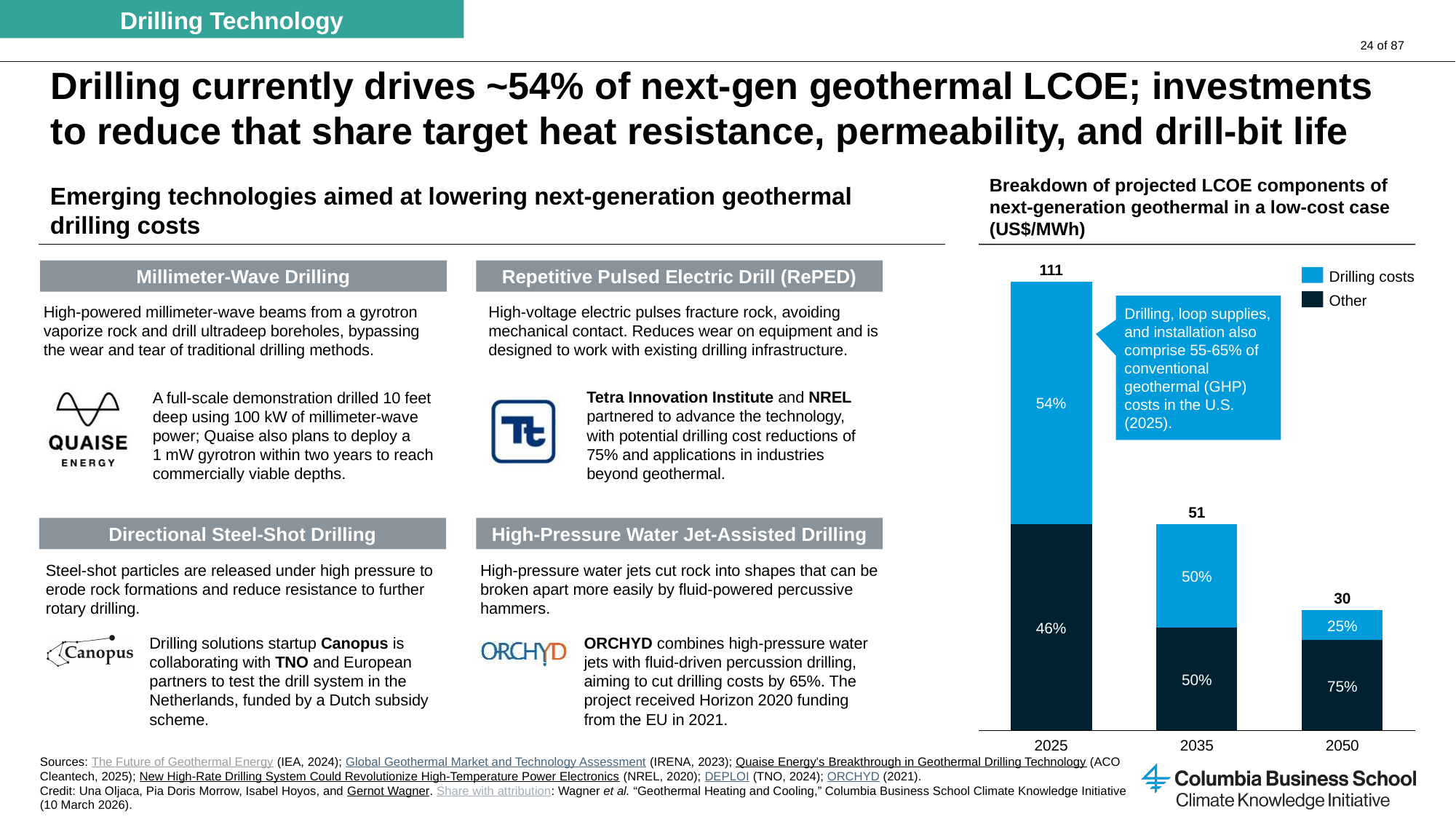
How many series does the chart legend list? 2 What is the total projected LCOE shown above the 2050 bar? 30 What percentage of the 2025 bar is labelled as Drilling costs? 54% What kind of chart is used to show the breakdown of projected LCOE components? Stacked bar chart What is the difference between the total LCOE for 2025 and 2035? 60 What percentage of the 2035 bar is labelled as Drilling costs? 50% Which year has the highest total projected LCOE? 2025 Is the total LCOE for 2035 larger or smaller than the total for 2050? larger How many years are shown on the x axis of the chart? 3 Which year has the lowest total projected LCOE? 2050 What is the total projected LCOE shown above the 2025 bar? 111 What percentage of the 2050 bar is labelled as Other? 75%